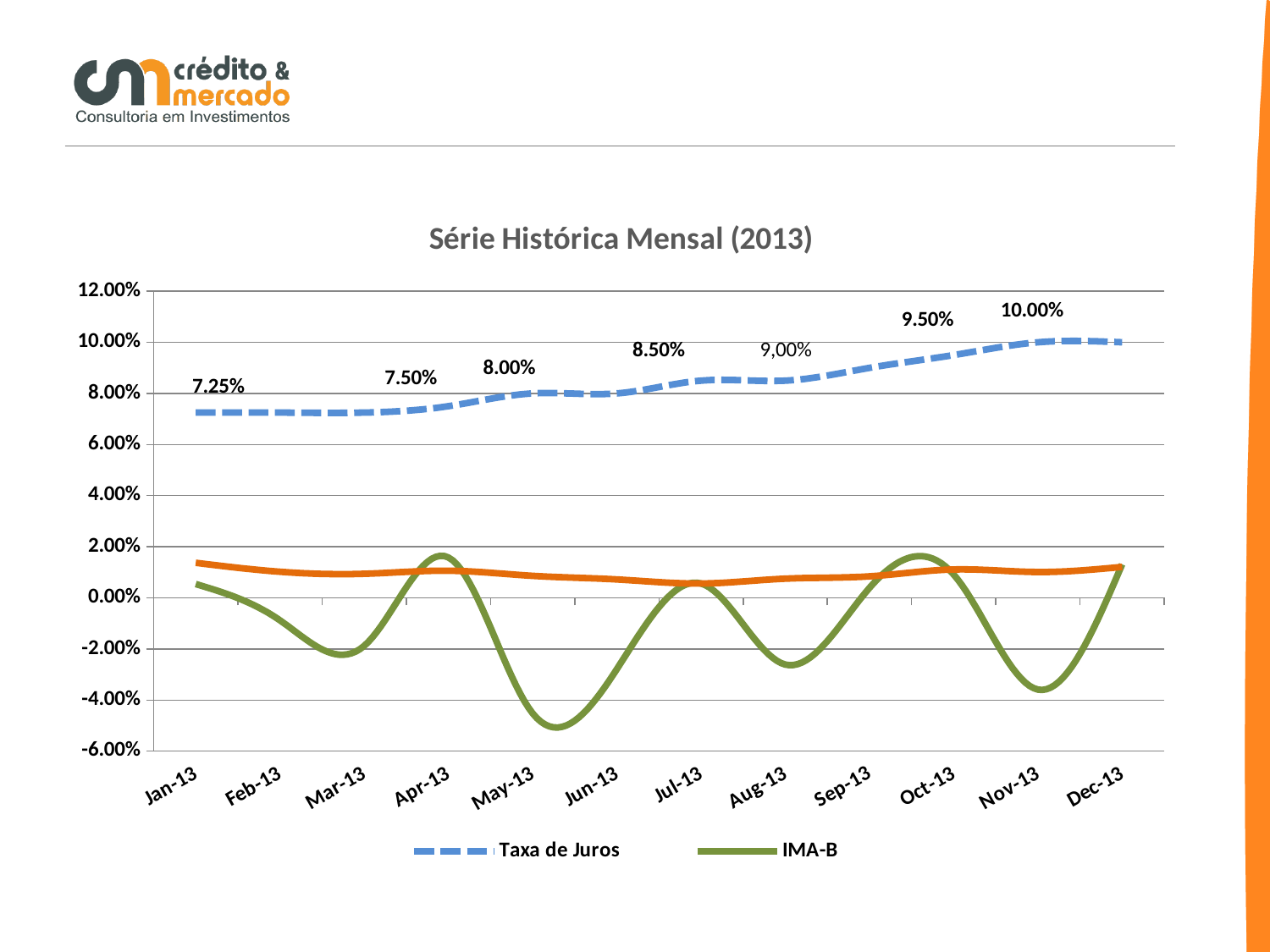
What is the Taxa de Juros value for Jul-13? 8.50% What kind of chart is shown on the slide? line chart How many months are shown on the x axis? 12 Does the Taxa de Juros series rise or fall from Jan-13 to Nov-13? rise What is the Taxa de Juros value for Nov-13? 10.00% What is the Taxa de Juros value for Jan-13? 7.25% Is the IMA-B value for May-13 greater or less than -4.00%? less What is the difference between the Taxa de Juros values for Nov-13 and Jan-13? 2.75% What is the title of the chart? Série Histórica Mensal (2013) In which month is the IMA-B series at its lowest? May-13 How many series does the legend list? 2 What is the Taxa de Juros value for Oct-13? 9.50%